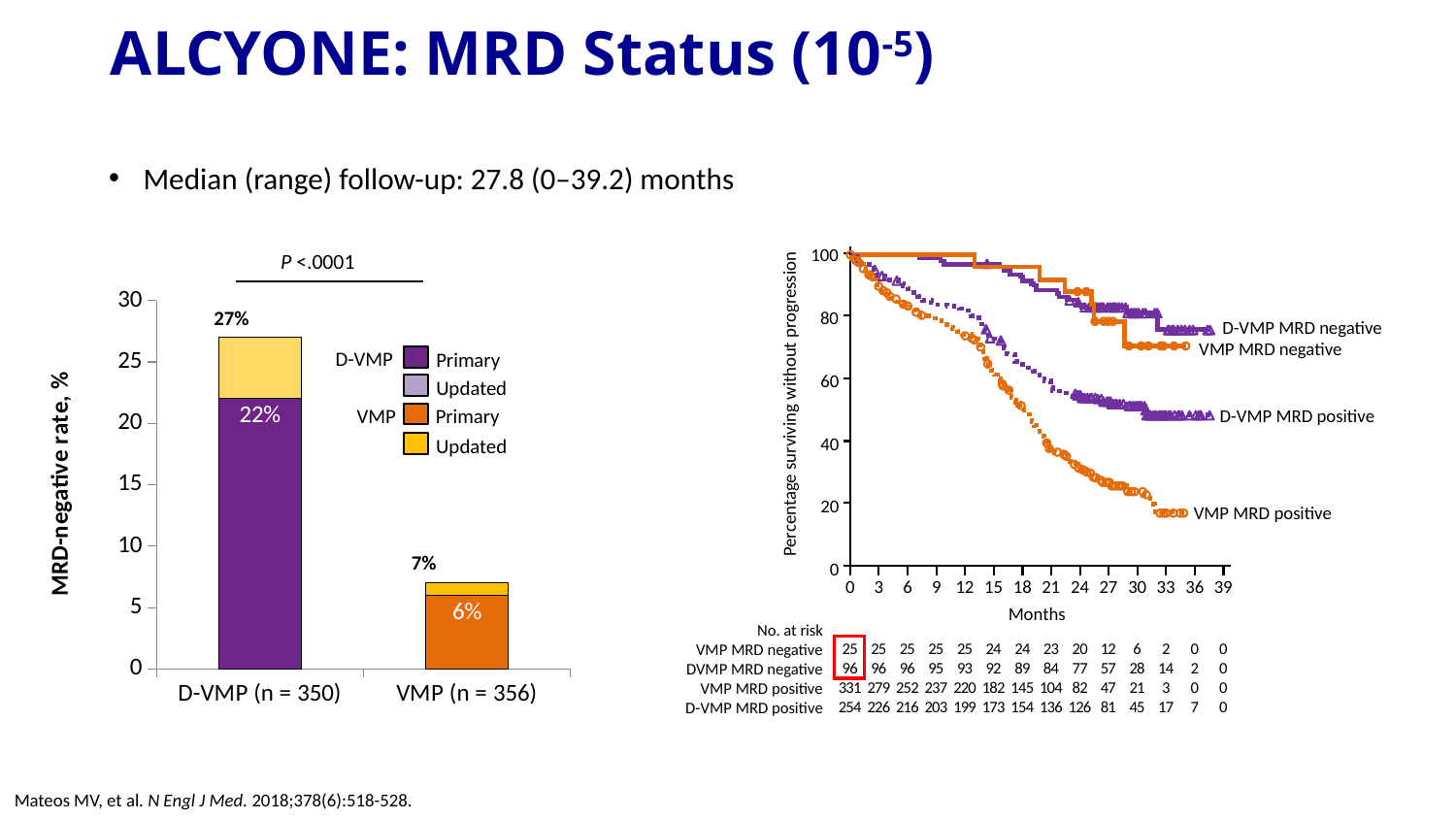
In the bar chart on the left, what is the primary MRD-negative rate for D-VMP (n = 350)? 22% What kind of chart is shown on the left of the slide? Stacked bar chart In the bar chart on the left, how many entries does the legend list? 4 In the chart on the right, do the percentage surviving without progression curves rise or fall as months increase? Fall In the bar chart on the left, which treatment group has the higher MRD-negative rate? D-VMP (n = 350) In the chart on the right, how many patients were at risk in the DVMP MRD negative group at month 0? 96 In the chart on the right, what is the label of the y axis? Percentage surviving without progression In the chart on the right, how many patients were at risk in the VMP MRD positive group at month 0? 331 In the bar chart on the left, what P value is shown above the bars? P <.0001 In the bar chart on the left, what is the difference between the total MRD-negative rates of D-VMP and VMP? 20% In the bar chart on the left, what is the primary MRD-negative rate for VMP (n = 356)? 6% In the bar chart on the left, what is the total MRD-negative rate for D-VMP (n = 350)? 27%